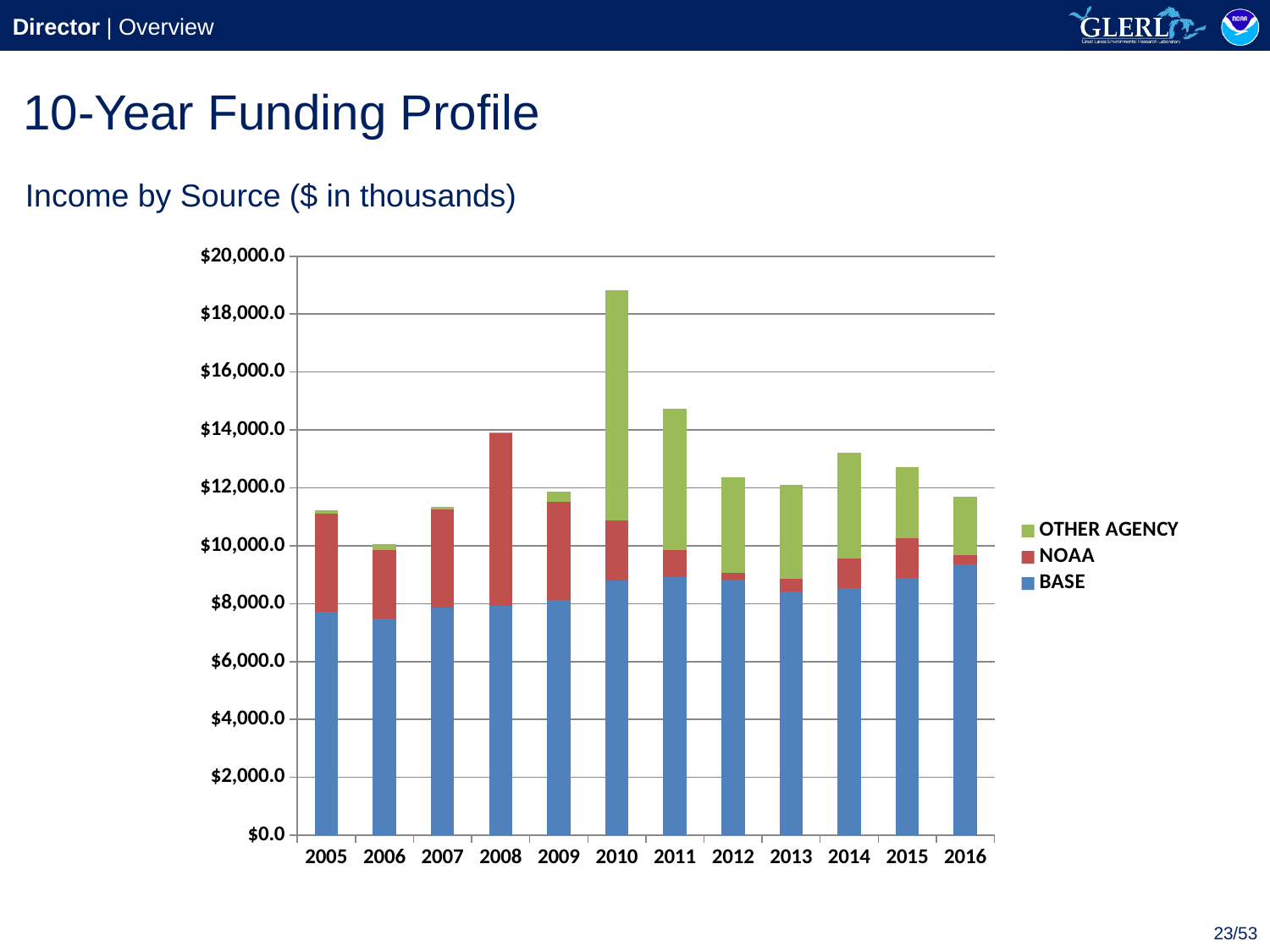
What kind of chart is shown on the slide? Stacked bar chart Which series is shown at the bottom of each stacked bar? BASE Which year has the highest total income in the chart? 2010 Which year has the larger total income, 2013 or 2014? 2014 Is the total income for 2010 greater or less than $18,000.0? greater Which year has the lowest total income in the chart? 2006 Do the total income values rise or fall from 2011 to 2013? Fall How many series does the chart's legend list? 3 How many years are shown on the x axis of the chart? 12 Which year has the larger total income, 2008 or 2009? 2008 Is the total income for 2016 greater or less than $14,000.0? less Is the total income for 2008 greater or less than $12,000.0? greater